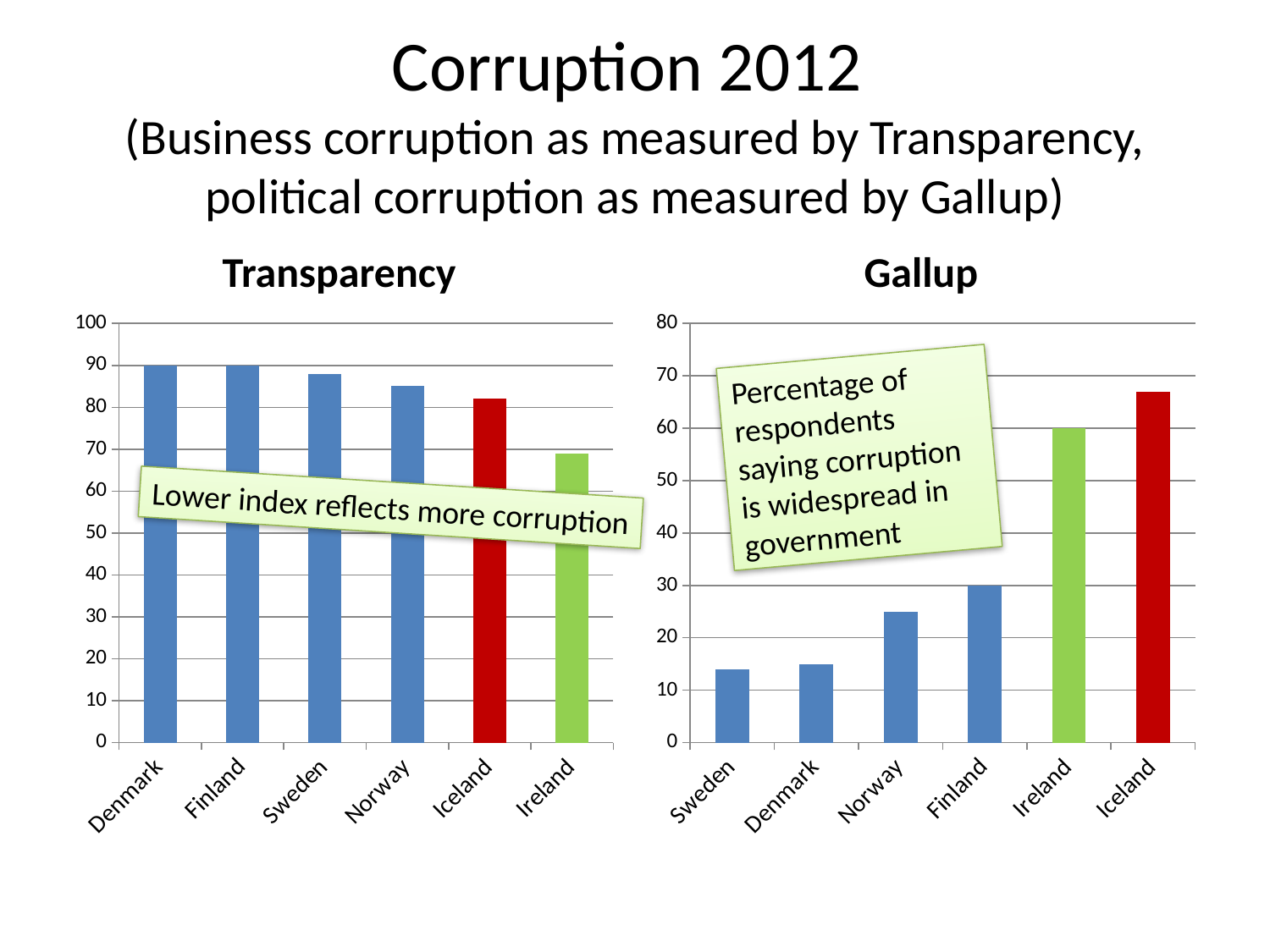
In the Gallup chart, do the values rise or fall from left to right along the x axis? Rise In the Transparency chart, what is the value for Denmark? 90 In the Gallup chart, is the value for Sweden greater or less than 20? less In the Transparency chart, is the value for Iceland greater or less than 80? greater What kind of chart is the Gallup chart? Bar chart In the Transparency chart, which country has the lowest value? Ireland In the Gallup chart, what is the value for Ireland? 60 How many countries are shown in the Transparency chart? 6 In the Gallup chart, which country has the highest value? Iceland In the Gallup chart, is the value for Norway greater or less than 20? greater In the Gallup chart, which is larger, the value for Ireland or the value for Iceland? Iceland In the Gallup chart, what is the value for Finland? 30